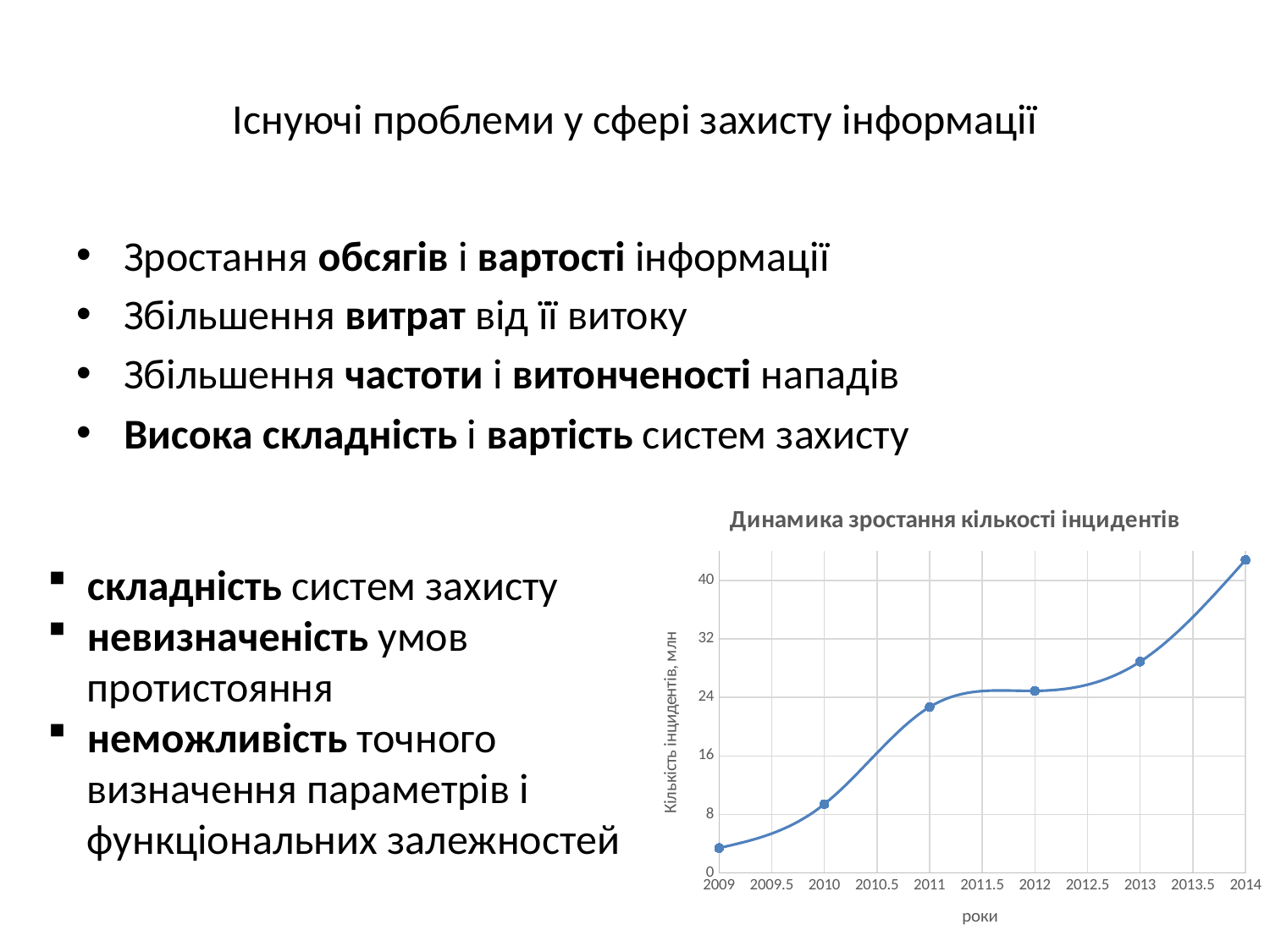
Is the value for 2014 greater or less than 40? greater Which year has the lowest number of incidents in the chart? 2009 Which year has the larger value, 2010 or 2013? 2013 What is the label of the vertical axis of the chart? Кількість інцидентів, млн Do the values in the chart rise or fall from 2009 to 2014? rise Is the value for 2009 greater or less than 8? less Which year has the highest number of incidents in the chart? 2014 What kind of chart is shown on the slide? line chart How many data points are plotted on the line in the chart? 6 What is the title of the chart on the slide? Динамика зростання кількості інцидентів Is the value for 2013 greater or less than 32? less